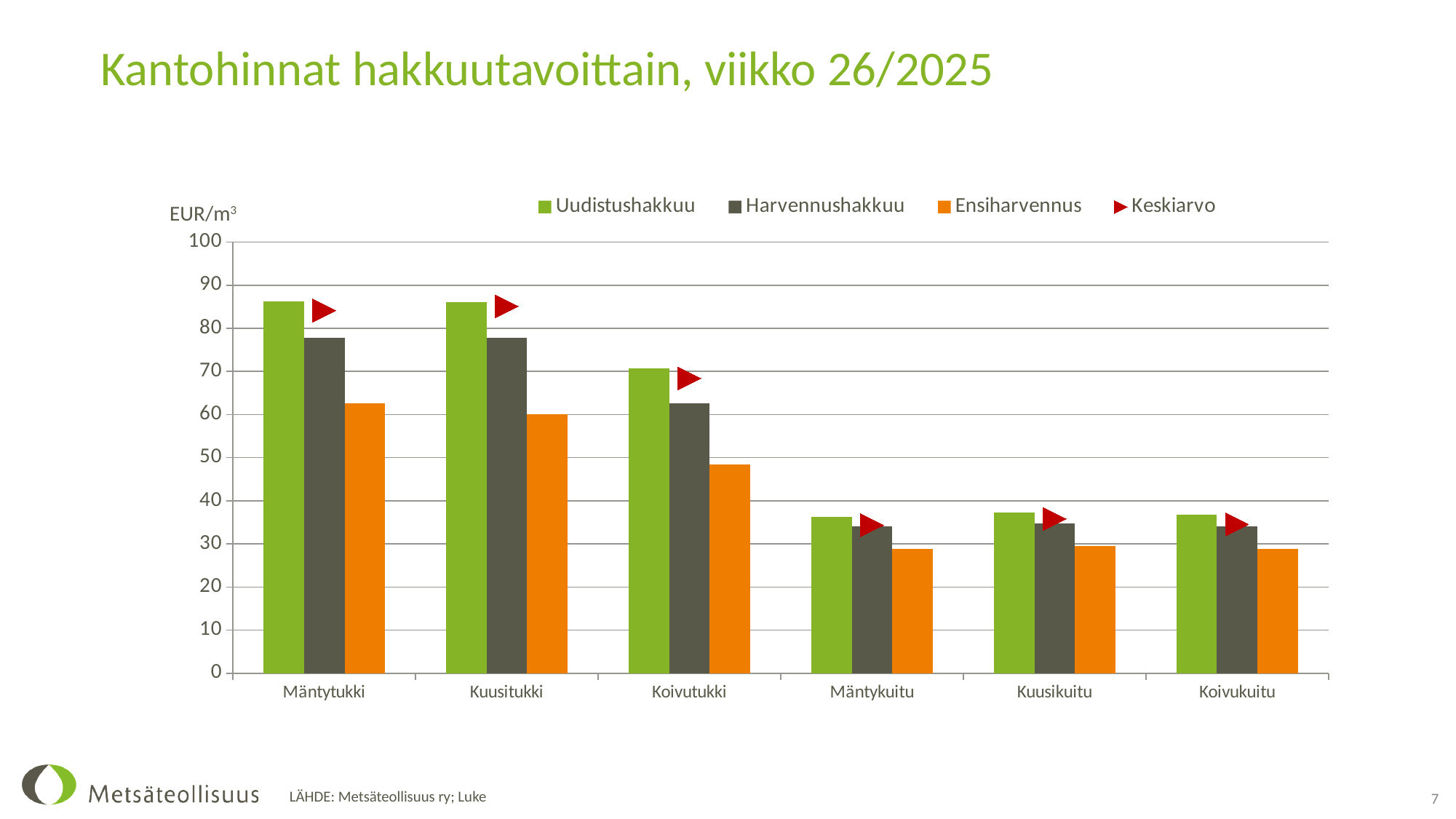
Is the Uudistushakkuu value for Mäntykuitu greater or less than 30? greater Is the Uudistushakkuu value for Mäntytukki greater or less than 80? greater Which is larger, the Uudistushakkuu value for Koivutukki or the Uudistushakkuu value for Mäntykuitu? Koivutukki Is the Ensiharvennus value for Koivutukki greater or less than 50? less Do the Ensiharvennus values generally rise or fall moving from Mäntytukki to Koivukuitu along the x axis? fall Which series has the highest value for Mäntytukki? Uudistushakkuu How many categories are shown on the x axis? 6 How many series does the legend list? 4 What unit is shown on the y axis? EUR/m³ What kind of chart is shown on the slide? bar chart